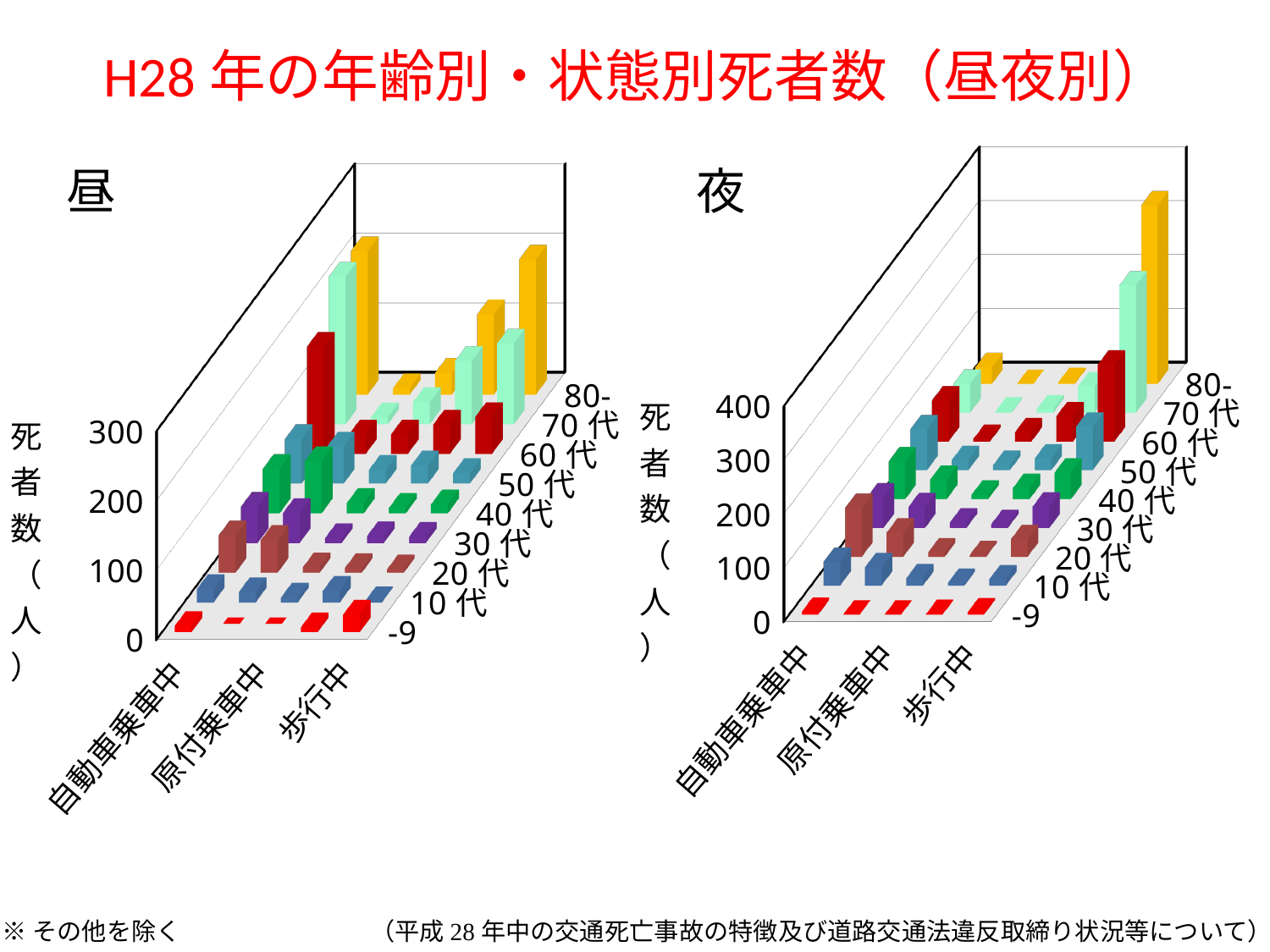
What is the vertical axis label of the 昼 chart? 死者数（人） Which chart has the higher maximum value on its vertical axis, 昼 or 夜? 夜 In the 夜 chart, is the value for 原付乗車中 in the 10代 age group greater or less than 100? less In the 夜 chart, which state and age group has the tallest bar? 歩行中, 80- How many charts are on the slide? 2 What kind of chart is the 昼 chart? bar chart In the 夜 chart, is the value for 歩行中 in the 80- age group greater or less than 200? greater In the 昼 chart, is the value for 自動車乗車中 in the -9 age group greater or less than 100? less In the 夜 chart, how many age groups are shown along the depth axis? 9 In the 昼 chart, which age group has the tallest bar for 歩行中? 80- In the 昼 chart, how many states (categories) are shown along the front axis? 5 What is the title of the slide? H28年の年齢別・状態別死者数（昼夜別）